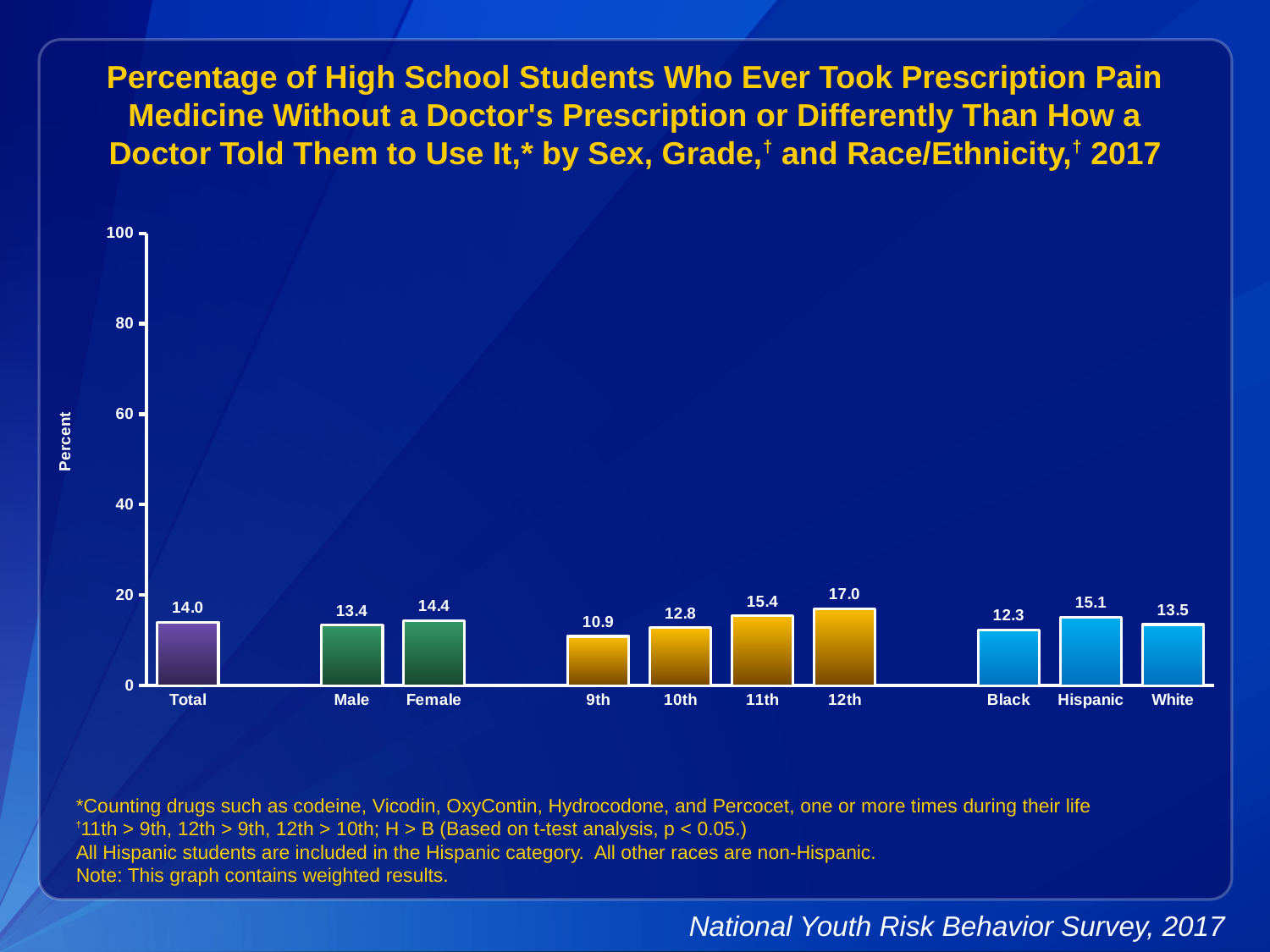
What kind of chart is shown on the slide? bar chart Is the value for 11th grade greater or less than 20? less Which category has the highest value? 12th What is the value for 12th grade students? 17.0 Which category has the lowest value? 9th What is the difference between the values for Female and Male? 1.0 What is the value for Total? 14.0 What is the value for Hispanic students? 15.1 What is the difference between the values for 12th and 9th grade? 6.1 Which is larger, the value for Black or the value for White? White How many bars are shown in the chart? 10 Do the values rise or fall from 9th grade to 12th grade? rise